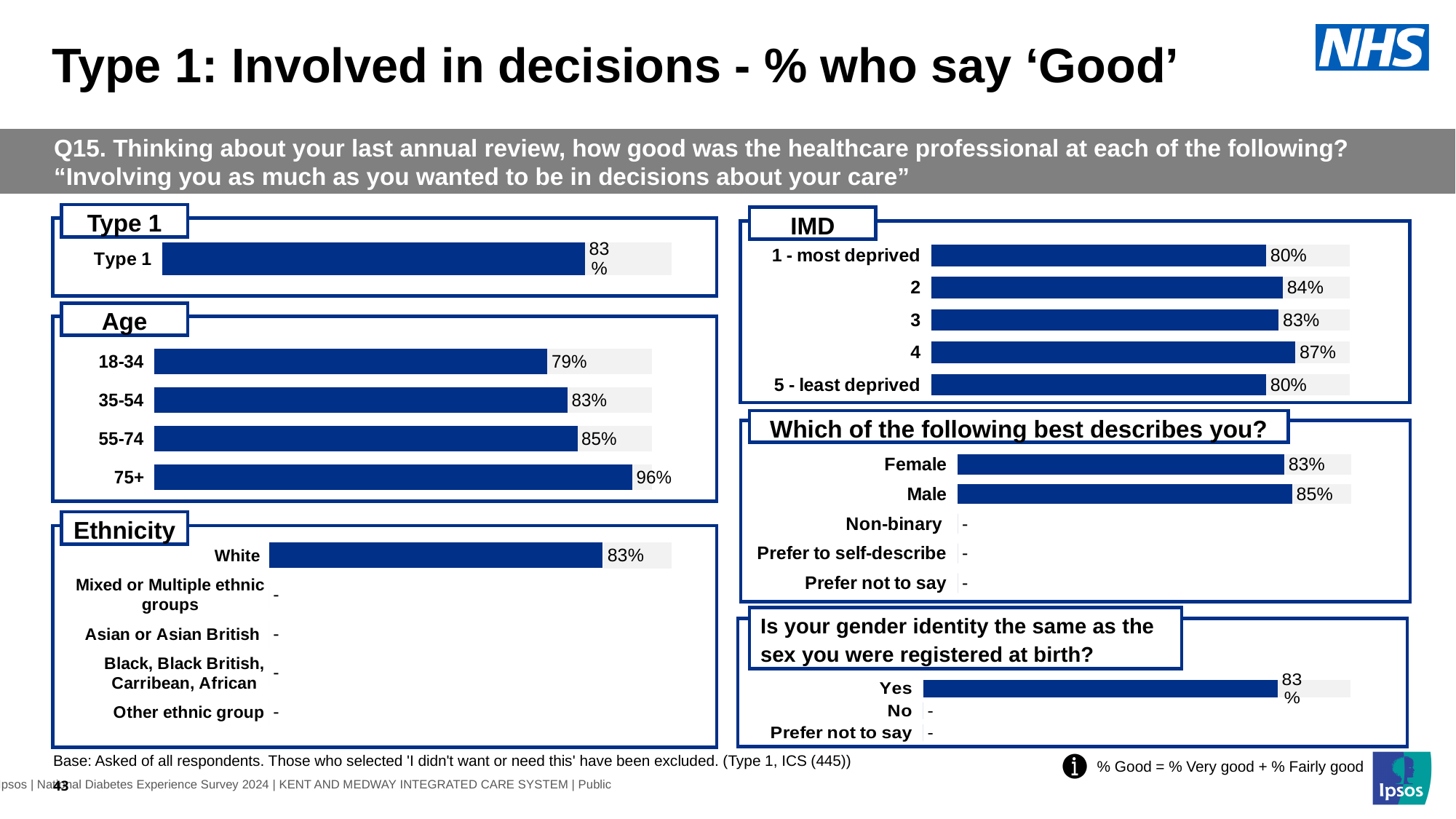
In the Ethnicity chart, what is the value for White? 83% In the IMD chart, what is the difference between the values for '4' and '1 - most deprived'? 7 percentage points In the Age chart, do the values rise or fall as age increases from 18-34 to 75+? rise What type of chart is used in the IMD section? bar chart How many categories are listed in the Ethnicity chart? 5 In the IMD chart, which category has the highest value? 4 In the 'Which of the following best describes you?' chart, which is larger, Female or Male? Male In the 'Is your gender identity the same as the sex you were registered at birth?' chart, what is the value for Yes? 83% In the 'Which of the following best describes you?' chart, what is the value for Female? 83% In the Age chart, which age group has the lowest value? 18-34 In the IMD chart, what is the value for '2'? 84% In the Age chart, what is the value for the 75+ age group? 96%